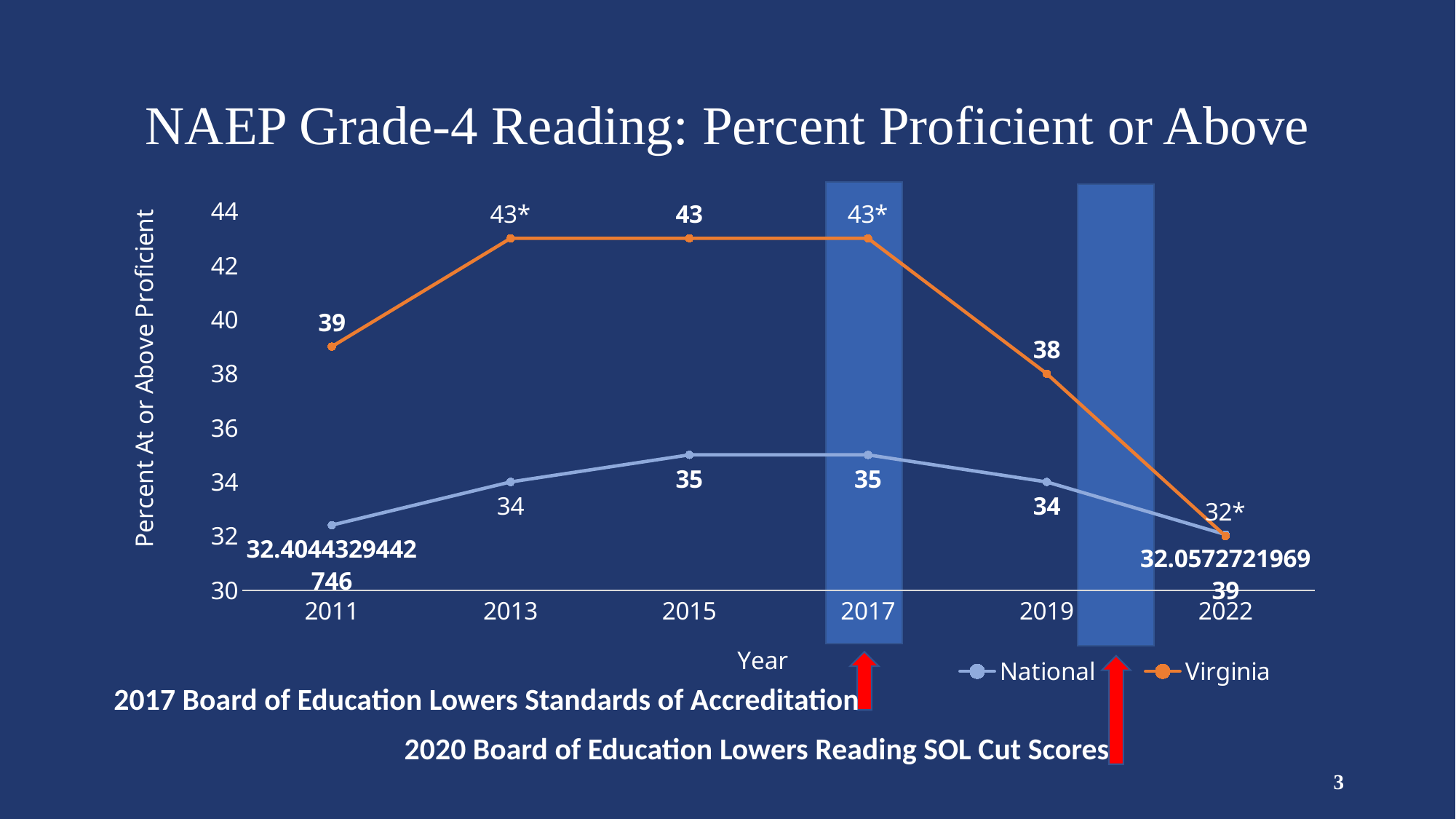
By how many percentage points did Virginia's value drop from 2017 to 2019? 5 Does Virginia's line rise or fall from 2017 to 2022? fall How many series does the legend list? 2 What was the National percent proficient or above in 2015? 35 In 2019, which series had the higher value, National or Virginia? Virginia What was Virginia's percent proficient or above in 2011? 39 What was the National percent proficient or above in 2019? 34 What kind of chart is shown on the slide? line chart What is the data label for Virginia in 2022? 32* In which year was Virginia's percent proficient or above lowest? 2022 How many years are plotted along the x axis? 6 What was Virginia's percent proficient or above in 2019? 38